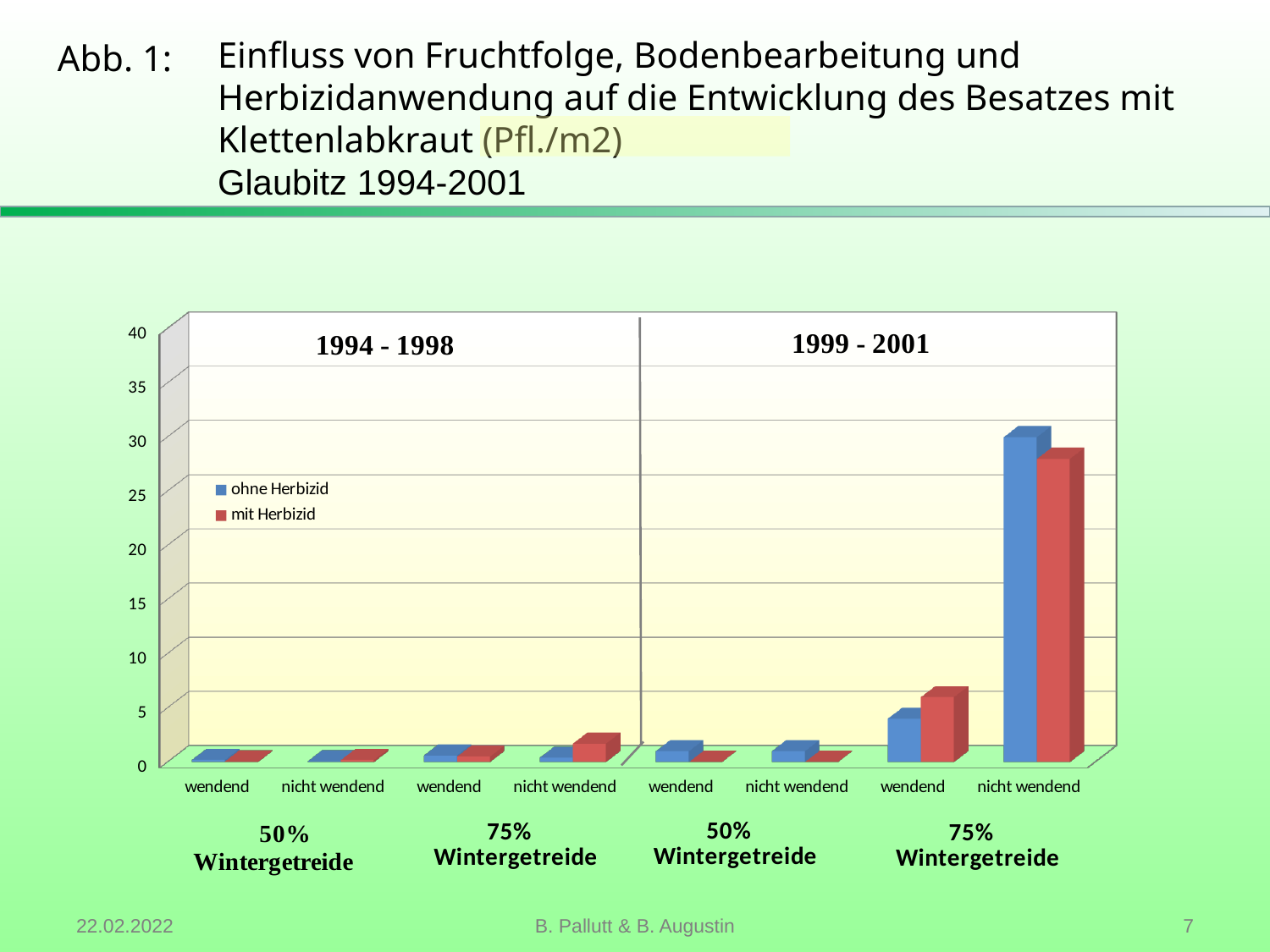
Which two time periods are labelled inside the chart area? 1994 - 1998 and 1999 - 2001 How many category groups (wendend / nicht wendend) are shown along the x axis? 8 For wendend, 75% Wintergetreide in 1999 - 2001, which series has the larger value: ohne Herbizid or mit Herbizid? mit Herbizid Is the 'ohne Herbizid' value for nicht wendend, 75% Wintergetreide in 1999 - 2001 greater or less than 25? greater Is the 'ohne Herbizid' value for nicht wendend, 75% Wintergetreide in 1999 - 2001 greater or less than 35? less How many series does the chart legend list? 2 Which category has the highest bar in the chart? nicht wendend, 75% Wintergetreide, 1999 - 2001 (ohne Herbizid) Are the bars for the 1994 - 1998 period generally higher or lower than those for 75% Wintergetreide in 1999 - 2001? lower What kind of chart is shown on the slide? bar chart Is the 'mit Herbizid' value for wendend, 75% Wintergetreide in 1999 - 2001 greater or less than 10? less What are the two series named in the chart legend? ohne Herbizid, mit Herbizid